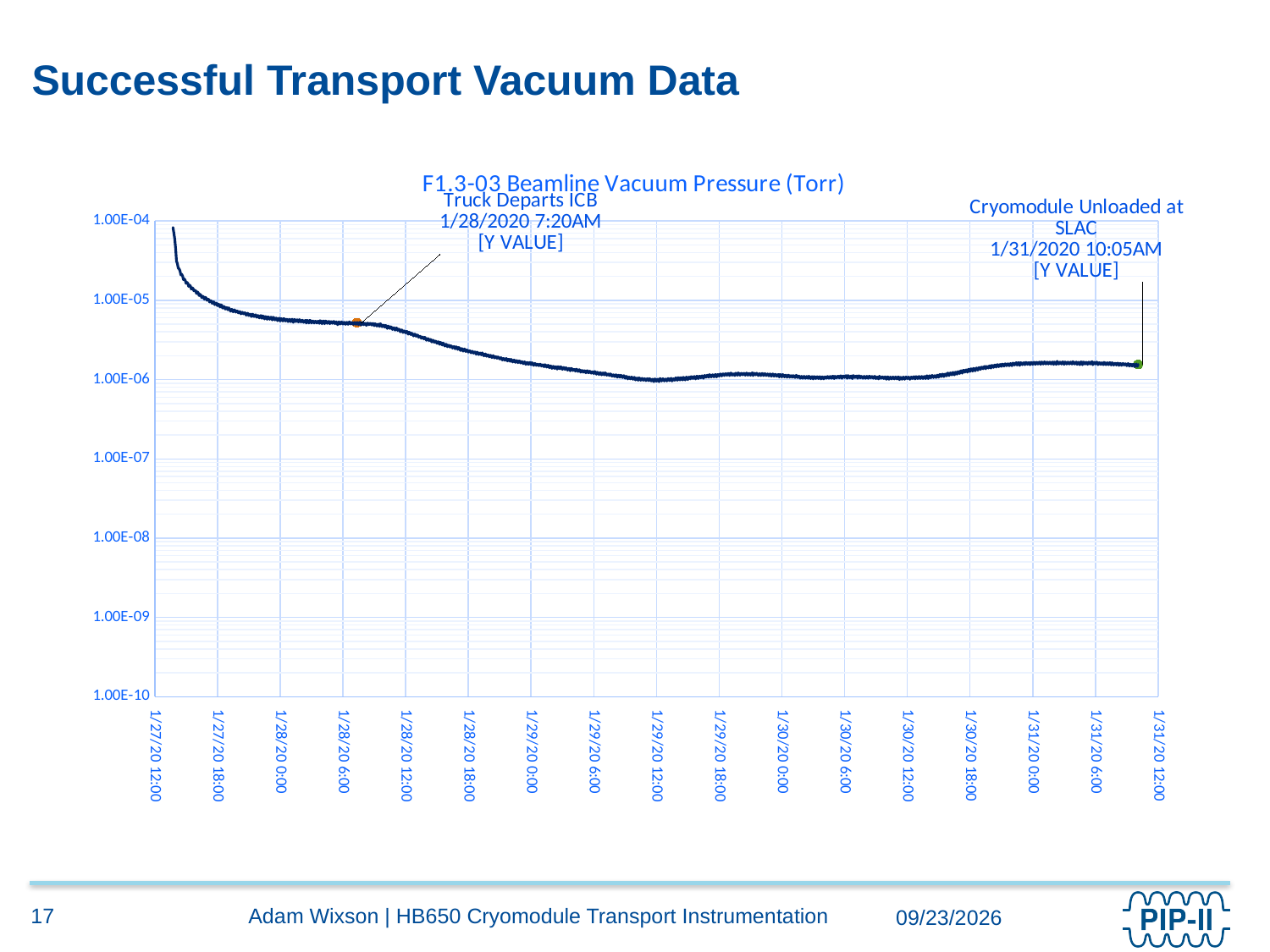
Is the vacuum pressure at the start of the data (1/27/20 12:00) greater or less than 1.00E-05? greater According to the chart annotation, when was the cryomodule unloaded at SLAC? 1/31/2020 10:05AM How many tick labels are shown on the y axis? 7 According to the chart annotation, when did the truck depart ICB? 1/28/2020 7:20AM Is the vacuum pressure at the 'Truck Departs ICB' point greater or less than 1.00E-05? less What is the lowest value labelled on the y axis? 1.00E-10 What is the title of the chart? F1.3-03 Beamline Vacuum Pressure (Torr) Is the vacuum pressure at the 'Truck Departs ICB' point greater or less than 1.00E-06? greater Does the vacuum pressure rise or fall between 1/28/20 6:00 and 1/29/20 12:00? fall Which point has the higher pressure: 'Truck Departs ICB' or 'Cryomodule Unloaded at SLAC'? Truck Departs ICB What kind of chart is shown on the slide? line chart